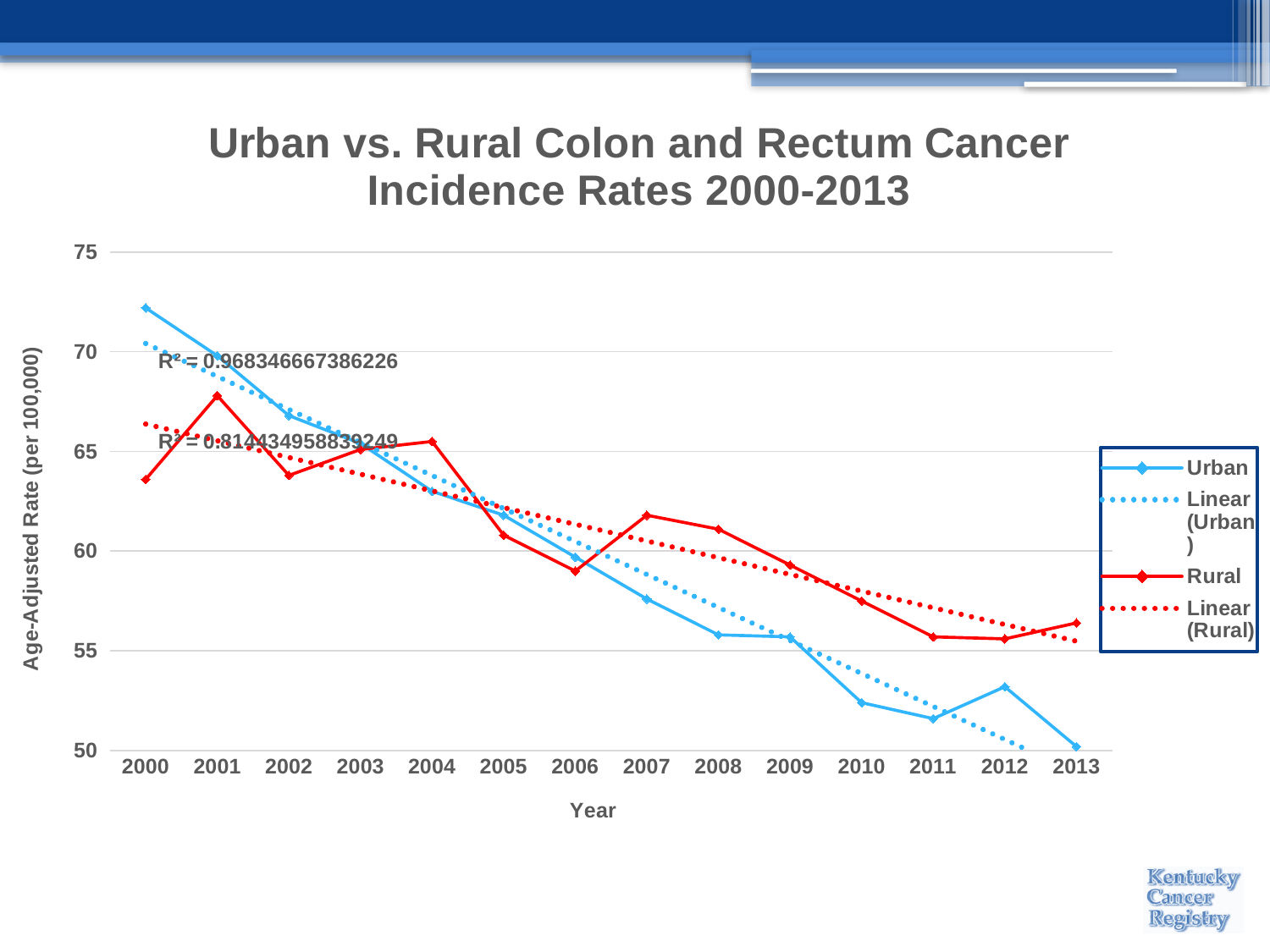
What kind of chart is shown on the slide? Line chart In which year is the Urban incidence rate highest? 2000 Is the Urban value for 2000 greater or less than 70? greater Is the Rural value for 2013 greater or less than 60? less What is the title of the y axis? Age-Adjusted Rate (per 100,000) Is the Urban value for 2013 greater or less than 55? less How many years are shown on the x axis? 14 In 2013, which series has the higher incidence rate, Urban or Rural? Rural How many entries does the legend list? 4 In 2000, which series has the higher incidence rate, Urban or Rural? Urban In which year is the Rural incidence rate highest? 2001 Do the Urban incidence rates rise or fall from 2000 to 2013? Fall